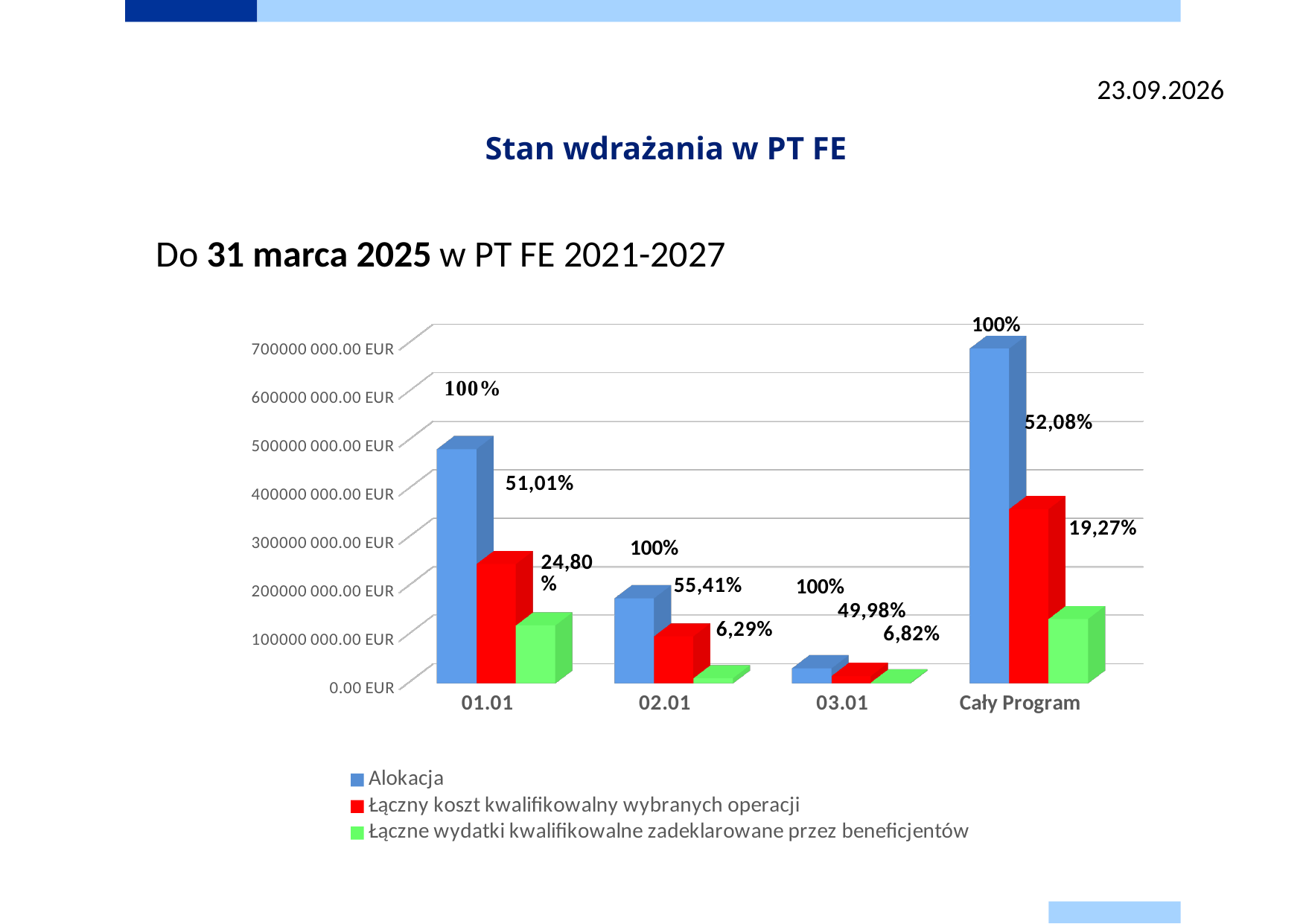
Is the Alokacja value for Cały Program greater or less than 600000 000.00 EUR? greater Which has the larger Alokacja bar, 02.01 or 03.01? 02.01 Which category has the lowest Alokacja bar? 03.01 Is the Alokacja value for 02.01 greater or less than 300000 000.00 EUR? less What kind of chart is shown on the slide? Bar chart Which category has the highest Alokacja bar? Cały Program How many series does the legend list? 3 What percentage label is shown for the Łączny koszt kwalifikowalny wybranych operacji bar for 01.01? 51,01% What percentage label is shown for the Łączne wydatki kwalifikowalne zadeklarowane przez beneficjentów bar for Cały Program? 19,27% What percentage label is shown for the Łączny koszt kwalifikowalny wybranych operacji bar for 03.01? 49,98% How many categories are shown on the x axis? 4 What percentage label is shown for the Łączne wydatki kwalifikowalne zadeklarowane przez beneficjentów bar for 02.01? 6,29%